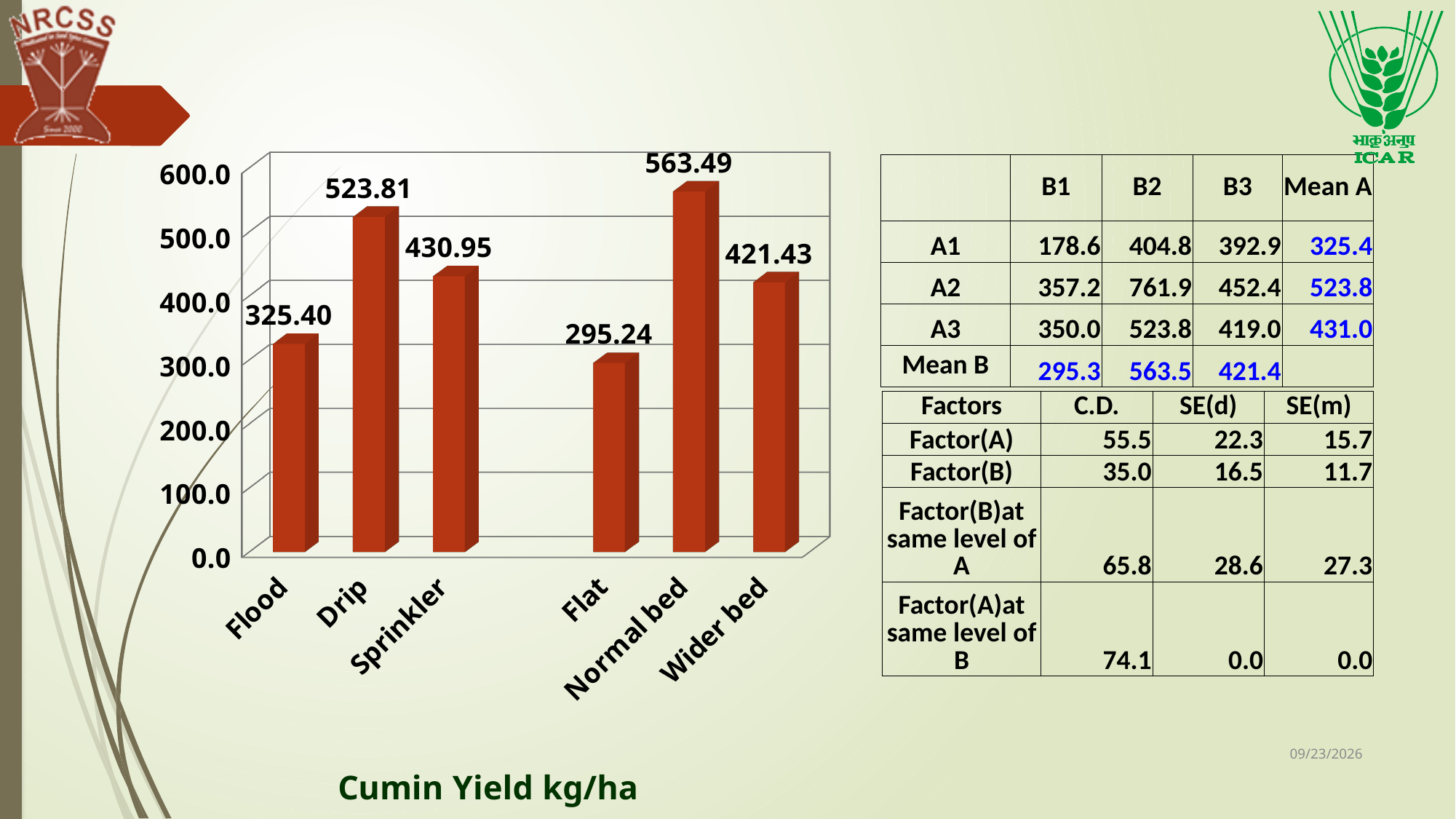
Is the value for Flood greater or less than 300.0? greater What is the difference between the values for Drip and Flood? 198.41 What is the difference between the values for Normal bed and Wider bed? 142.06 What is the value for Normal bed in the chart? 563.49 What caption is shown below the chart? Cumin Yield kg/ha What is the value for Flat in the chart? 295.24 Which is larger, the value for Sprinkler or the value for Wider bed? Sprinkler Which category has the lowest value in the chart? Flat What is the value for Drip in the chart? 523.81 Which category has the highest value in the chart? Normal bed What kind of chart is shown on the slide? bar chart How many categories are shown on the x axis of the chart? 6